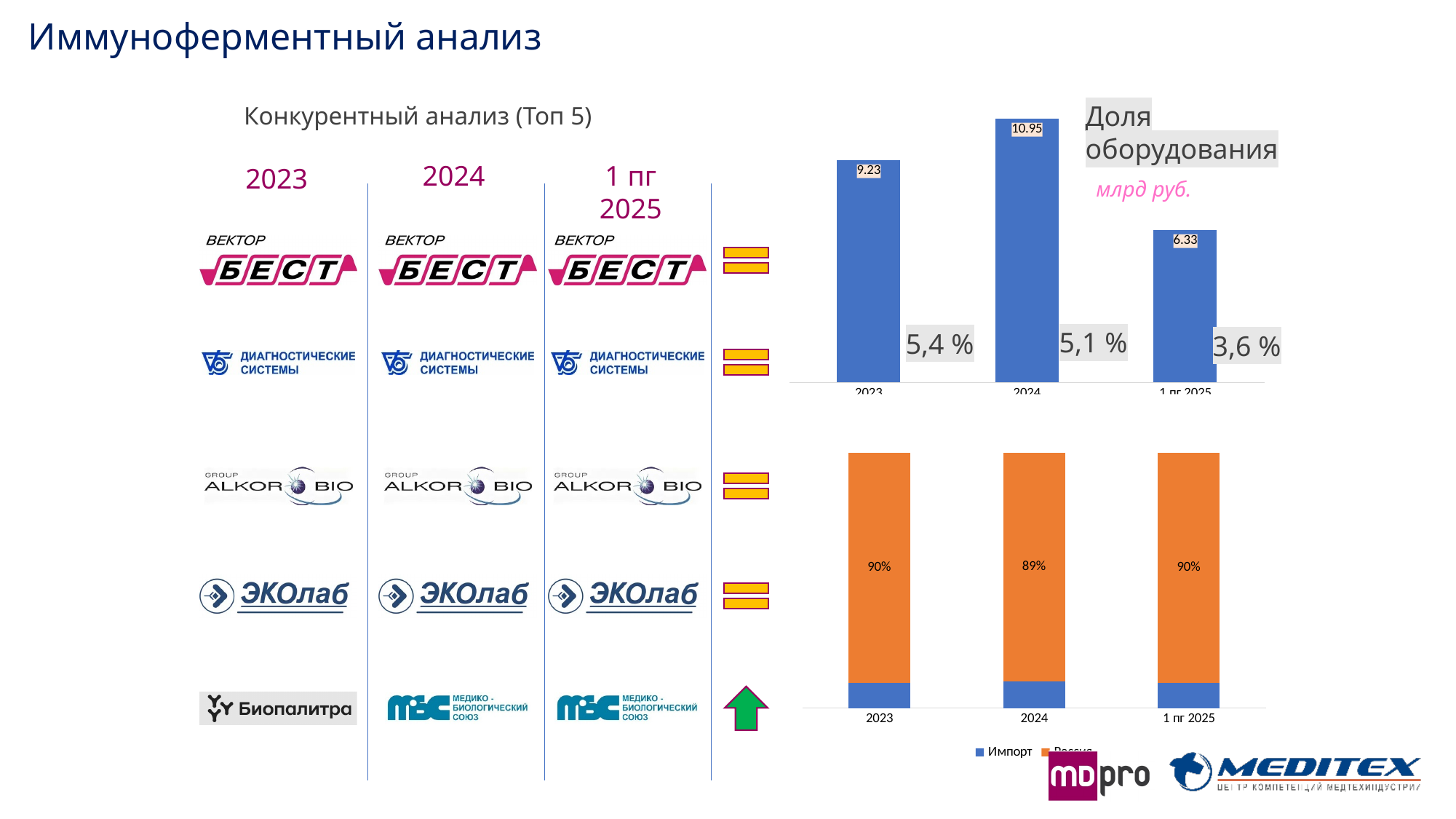
In the top chart, what is the difference between the values for 2024 and 2023? 1.72 In the top chart, which period has the highest value? 2024 In the top chart, what is the value for 2024? 10.95 In the bottom chart, what is the value labelled on the orange segment for 2024? 89% How many periods are shown on the x axis of the top chart? 3 In the top chart, what is the value for 1 пг 2025? 6.33 In the top chart, which is larger, the value for 2023 or the value for 1 пг 2025? 2023 In the top chart, what share percentage is shown next to the 2023 bar? 5,4 % How many series does the legend of the bottom chart list? 2 In the top chart, which period has the lowest value? 1 пг 2025 What kind of chart is the bottom chart? stacked bar chart In the top chart, does the value rise or fall from 2024 to 1 пг 2025? fall